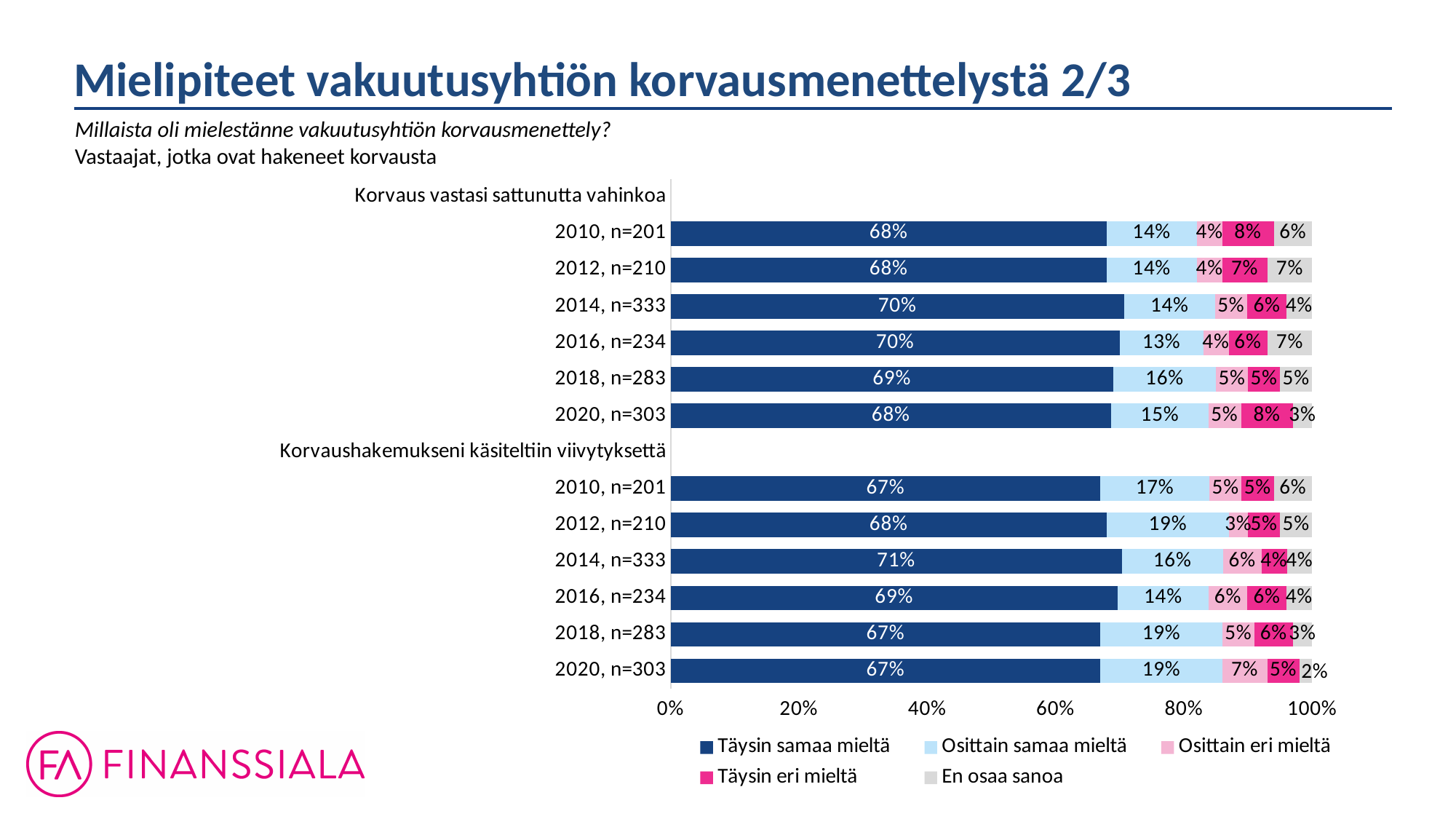
In the group 'Korvaus vastasi sattunutta vahinkoa', what is the 'Täysin eri mieltä' value for 2010, n=201? 8% In the group 'Korvaushakemukseni käsiteltiin viivytyksettä', which is larger: the 'Osittain eri mieltä' value for 2020, n=303 or for 2012, n=210? 2020, n=303 In the group 'Korvaus vastasi sattunutta vahinkoa', what is the 'Täysin samaa mieltä' value for 2020, n=303? 68% What colour represents 'Täysin eri mieltä' in the legend? Pink (magenta) What kind of chart is shown on the slide? Stacked bar chart How many series does the legend list? 5 In the group 'Korvaus vastasi sattunutta vahinkoa', what is the difference between the 'Osittain samaa mieltä' values for 2018, n=283 and 2016, n=234? 3% In the group 'Korvaushakemukseni käsiteltiin viivytyksettä', which year has the highest 'Täysin samaa mieltä' value? 2014, n=333 In the group 'Korvaus vastasi sattunutta vahinkoa', which year has the lowest 'En osaa sanoa' value? 2020, n=303 In the group 'Korvaushakemukseni käsiteltiin viivytyksettä', what is the 'En osaa sanoa' value for 2020, n=303? 2% How many bars are plotted in the chart in total? 12 In the group 'Korvaushakemukseni käsiteltiin viivytyksettä', what is the 'Osittain samaa mieltä' value for 2018, n=283? 19%